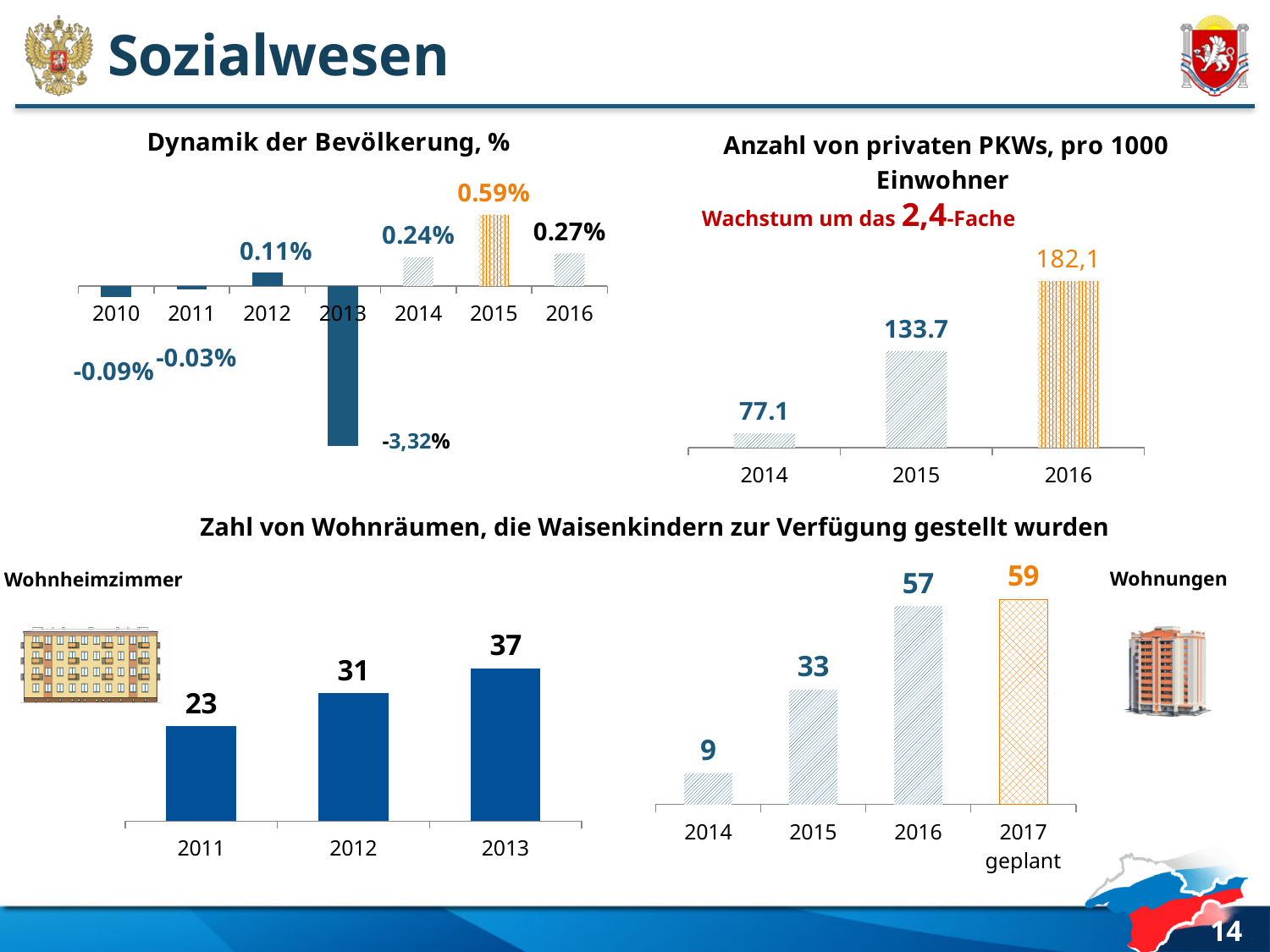
In the 'Anzahl von privaten PKWs, pro 1000 Einwohner' chart, which year has the highest value? 2016 In the 'Wohnungen' chart, which is larger, the value for 2015 or the value for 2016? 2016 In the 'Dynamik der Bevölkerung, %' chart, what is the value for 2013? -3,32% In the 'Anzahl von privaten PKWs, pro 1000 Einwohner' chart, do the values rise or fall from 2014 to 2016? rise What kind of chart is the 'Wohnungen' chart? bar chart In the 'Wohnheimzimmer' chart, what is the difference between the values for 2013 and 2011? 14 In the 'Wohnheimzimmer' chart, what is the value for 2012? 31 In the 'Dynamik der Bevölkerung, %' chart, how many years are shown on the x axis? 7 In the 'Wohnungen' chart, what is the value for 2017 geplant? 59 In the 'Dynamik der Bevölkerung, %' chart, which year has the lowest value? 2013 In the 'Anzahl von privaten PKWs, pro 1000 Einwohner' chart, what is the value for 2015? 133.7 In the 'Dynamik der Bevölkerung, %' chart, what is the value for 2015? 0.59%